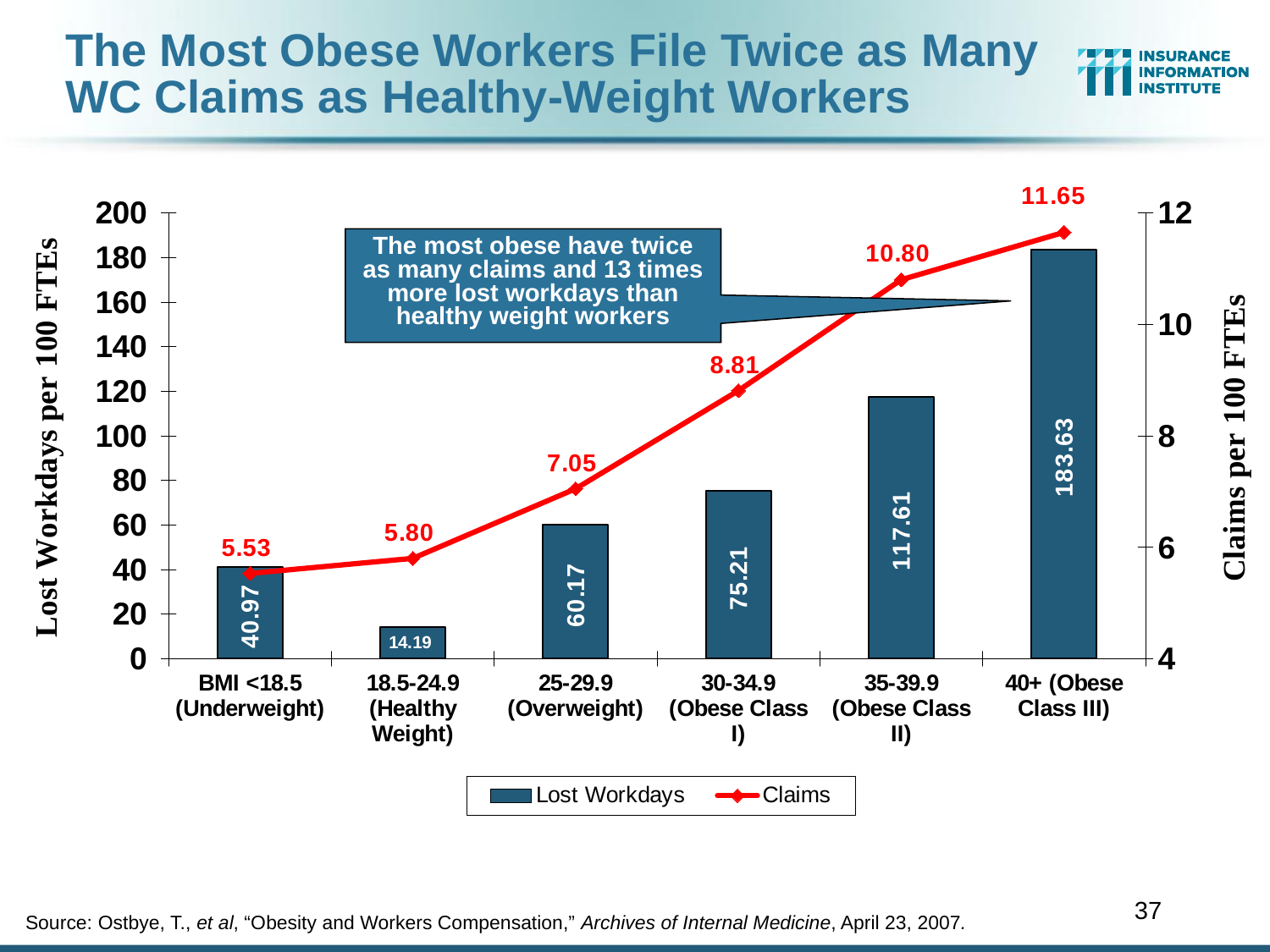
Do the Claims values rise or fall moving from left to right across the BMI categories? rise Which category has the lowest Lost Workdays value? 18.5-24.9 (Healthy Weight) What is the Lost Workdays value for the 40+ (Obese Class III) category? 183.63 Which category has the highest Claims value? 40+ (Obese Class III) Which is larger, the Lost Workdays value for BMI <18.5 (Underweight) or for 25-29.9 (Overweight)? 25-29.9 (Overweight) How many BMI categories are shown on the x axis? 6 What is the label of the right-hand vertical axis? Claims per 100 FTEs What is the Claims value for the 30-34.9 (Obese Class I) category? 8.81 What is the difference in Claims between the 40+ (Obese Class III) and 18.5-24.9 (Healthy Weight) categories? 5.85 What is the Lost Workdays value for the 35-39.9 (Obese Class II) category? 117.61 What is the Claims value for the 18.5-24.9 (Healthy Weight) category? 5.80 How many series does the legend list? 2